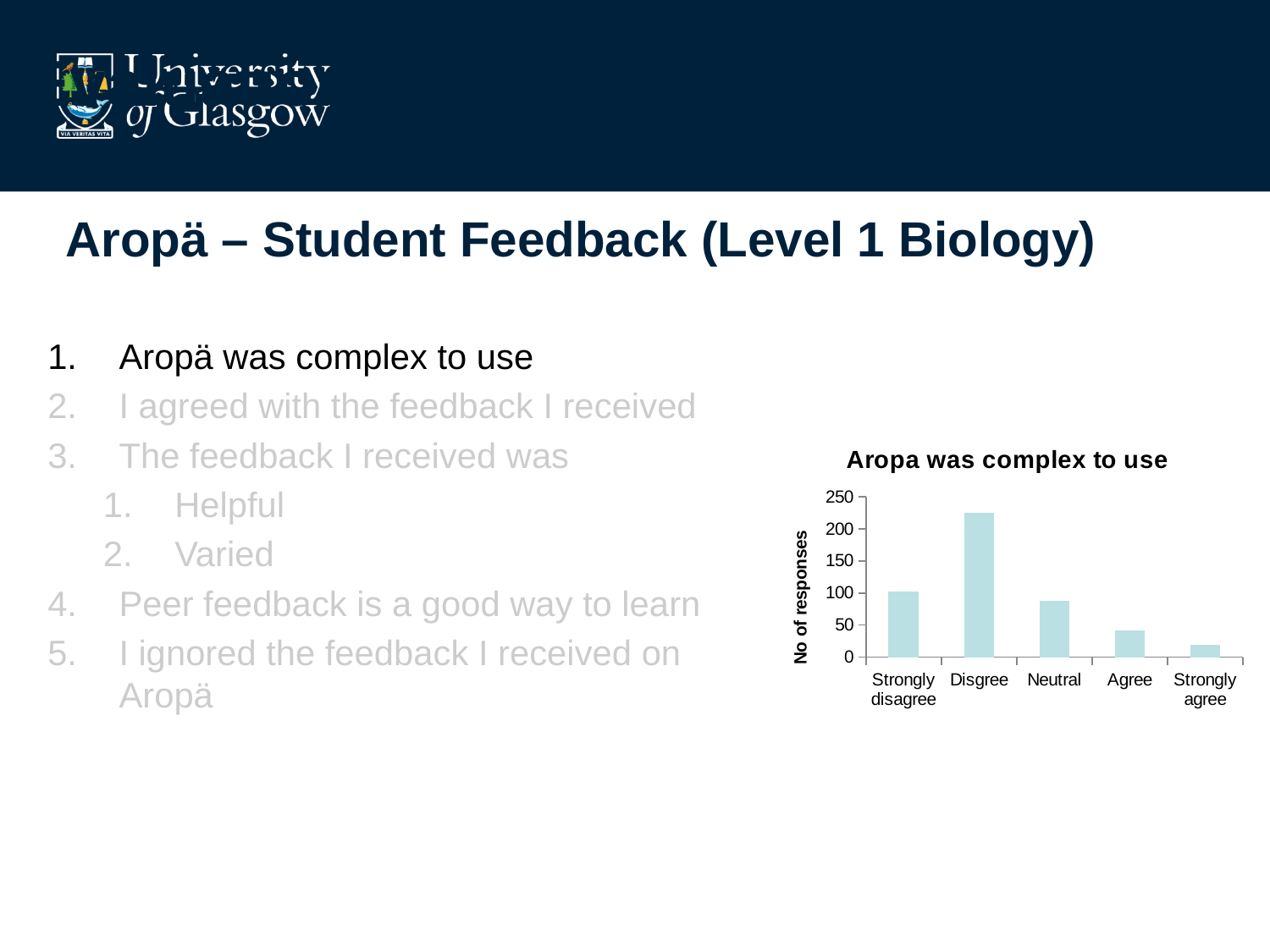
Is the value for Disgree greater or less than 200? greater Which response category has the highest number of responses? Disgree Which response category has the lowest number of responses? Strongly agree How many response categories are shown on the x axis of the chart? 5 Which has more responses, Disgree or Strongly disagree? Disgree What kind of chart is shown on the slide? bar chart Is the value for Neutral greater or less than 100? less What is the label on the vertical axis of the chart? No of responses Which has more responses, Agree or Strongly agree? Agree What is the title of the chart? Aropa was complex to use Is the value for Strongly agree greater or less than 50? less